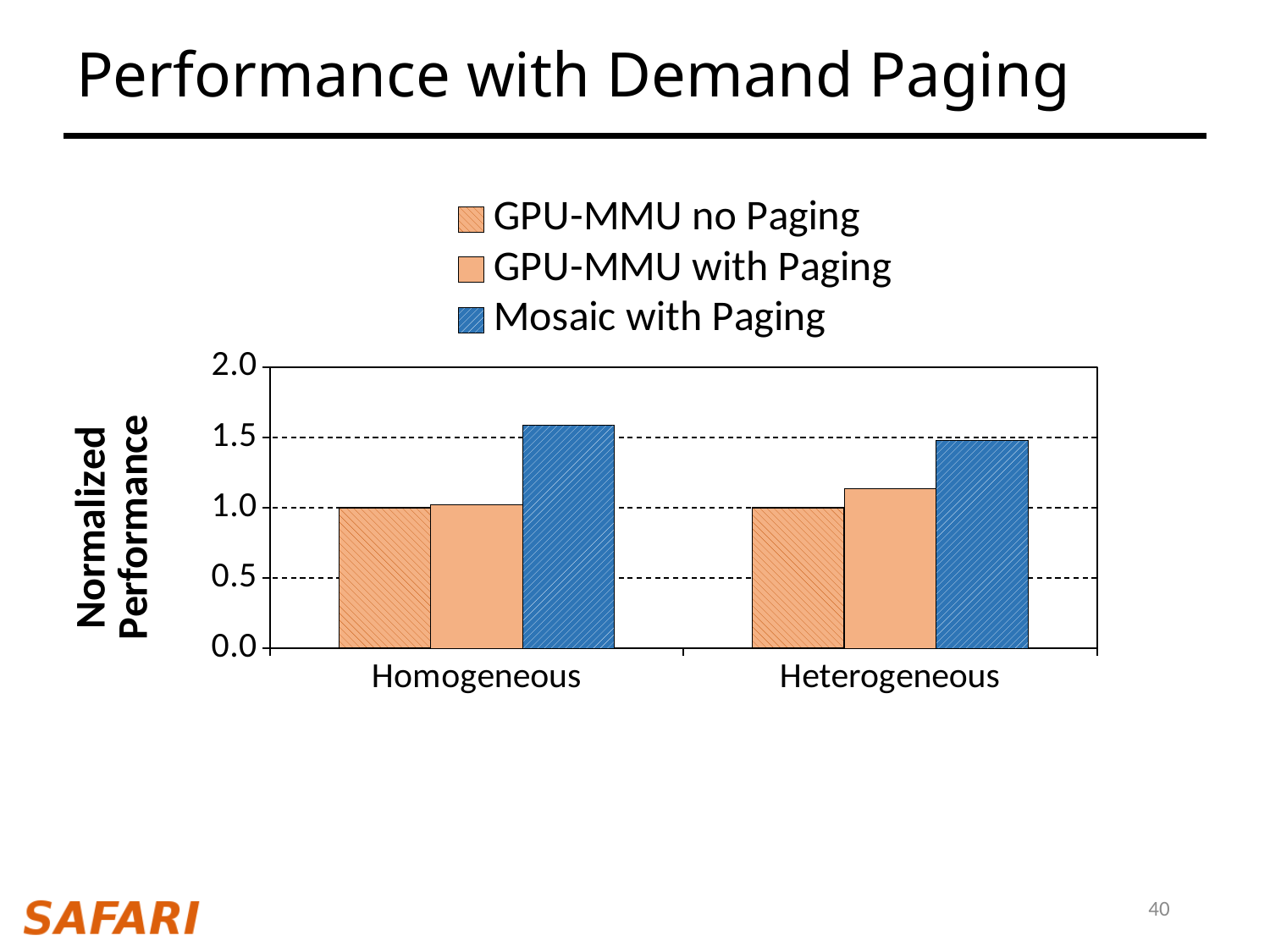
Which is larger: Mosaic with Paging for Homogeneous or Mosaic with Paging for Heterogeneous? Homogeneous Is the value for Mosaic with Paging in the Homogeneous category greater or less than 1.5? greater What kind of chart is shown on the slide? bar chart How many series does the legend list? 3 Which series has the highest normalized performance in the Homogeneous category? Mosaic with Paging What is the normalized performance of GPU-MMU no Paging for the Heterogeneous category? 1.0 What is the label of the y axis? Normalized Performance Is the value for GPU-MMU with Paging in the Heterogeneous category greater or less than 1.0? greater Is the value for Mosaic with Paging in the Heterogeneous category greater or less than 1.0? greater What is the normalized performance of GPU-MMU no Paging for the Homogeneous category? 1.0 How many categories are shown on the x axis? 2 Which series has the highest normalized performance in the Heterogeneous category? Mosaic with Paging